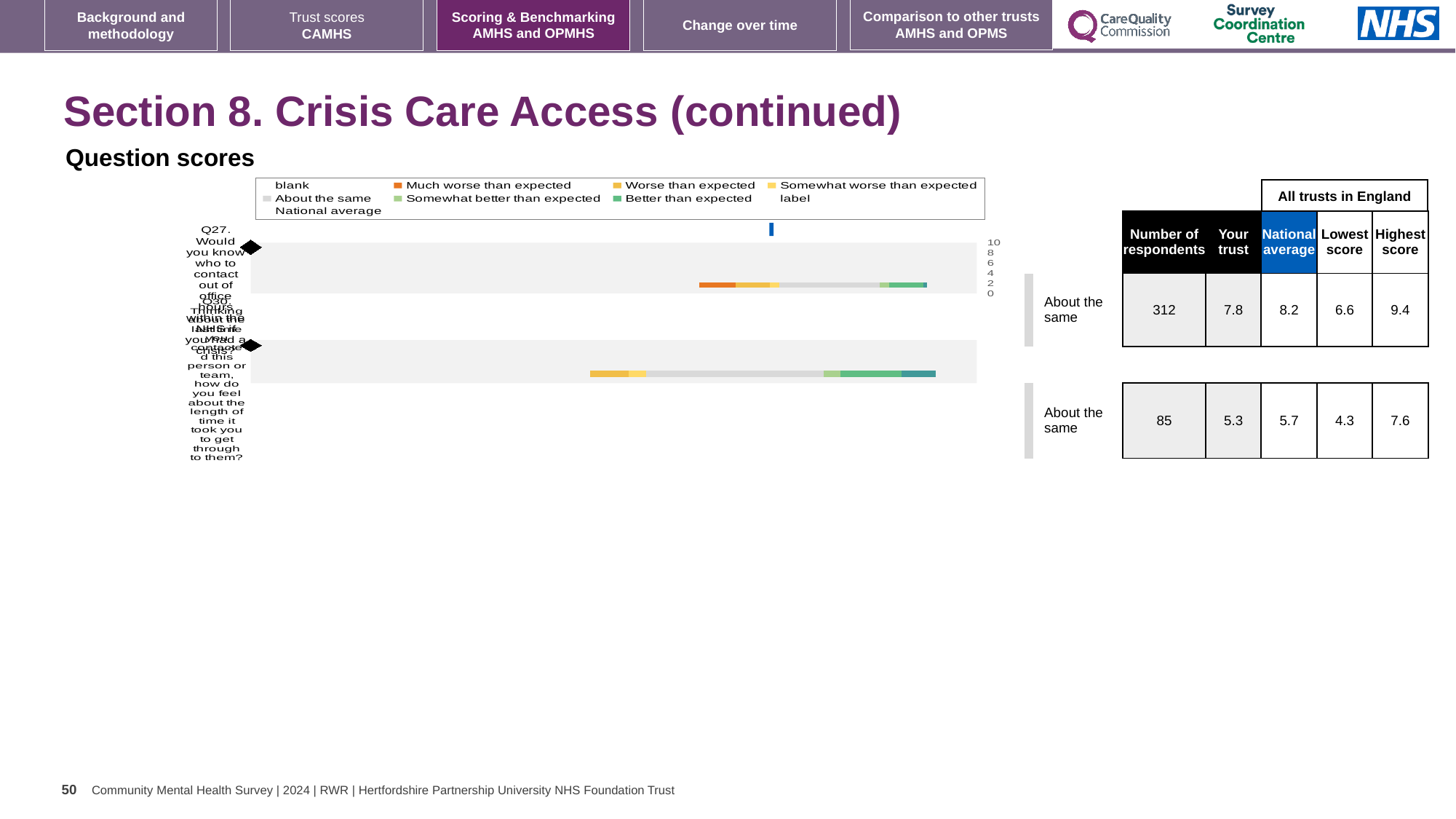
How many questions (bars) are plotted in the question scores chart? 2 What kind of chart is used to show the question scores on this slide? bar chart For Q27, which is larger: the 'Your trust' score or the national average? National average What is the highest score across all trusts in England for Q30? 7.6 What benchmark category is shown for Q27 in the question scores chart? About the same What is the 'Your trust' score for Q27 in the table beside the question scores chart? 7.8 How many respondents are listed for Q27 in the table beside the question scores chart? 312 In the question scores chart legend, which entry is shown in orange? Much worse than expected How many entries does the legend of the question scores chart list? 9 What is the national average score for Q30 in the table beside the question scores chart? 5.7 What is the difference in the number of respondents between Q27 and Q30? 227 What is the difference between the highest score and the lowest score for Q27? 2.8